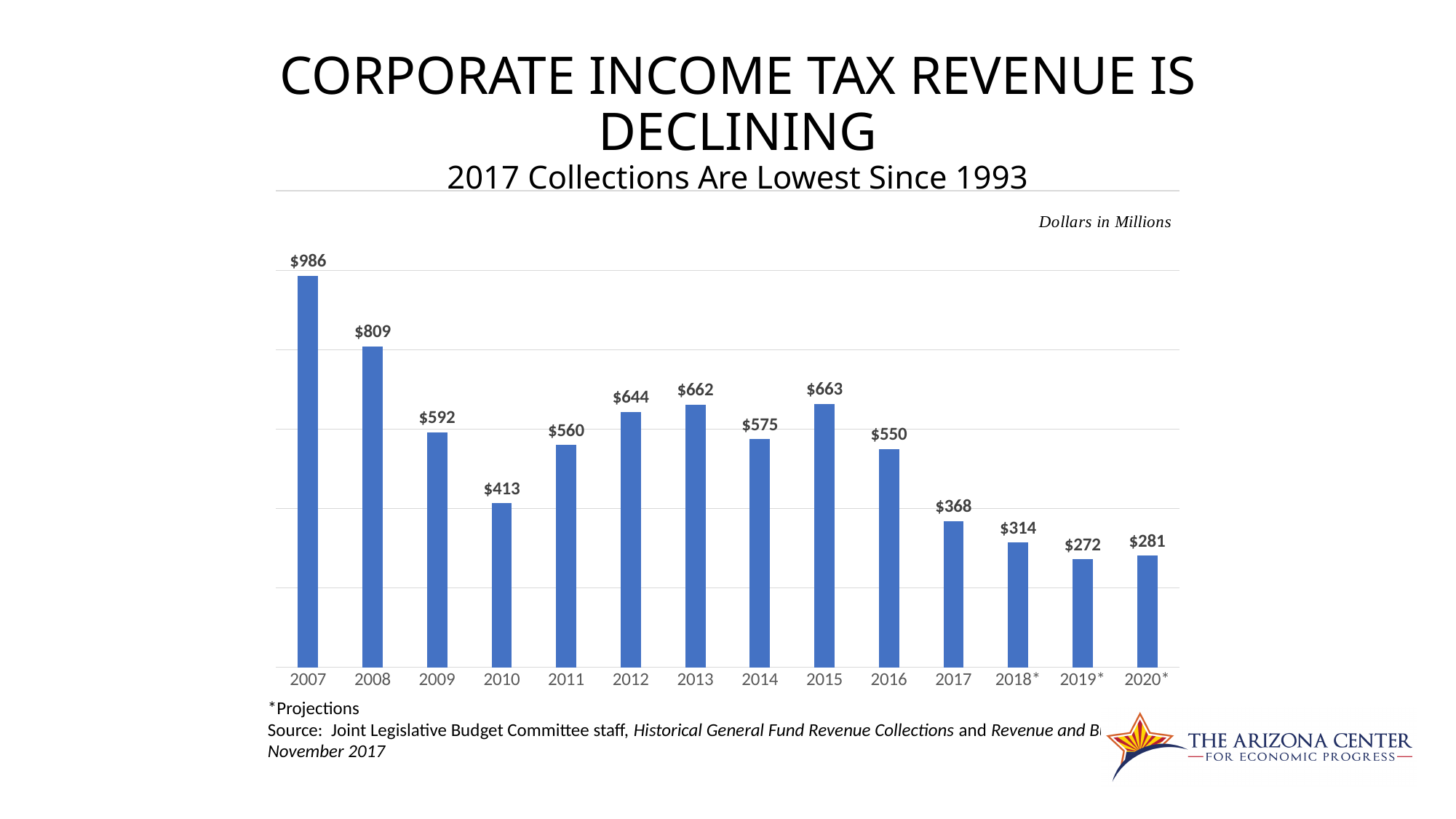
Which is larger, the value for 2012 or the value for 2014? 2012 How many years (bars) are shown on the chart? 14 What kind of chart is shown on the slide? Bar chart What unit are the values on the chart expressed in, according to the note above the chart? Dollars in Millions Overall, do the values rise or fall from 2007 to 2020*? Fall What is the corporate income tax revenue value for 2007? $986 What is the difference between the 2016 value and the 2017 value? $182 What is the projected value for 2020*? $281 What is the value shown for 2017? $368 What is the difference between the 2007 value and the 2008 value? $177 Which year has the lowest value on the chart? 2019* Which year has the highest value on the chart? 2007